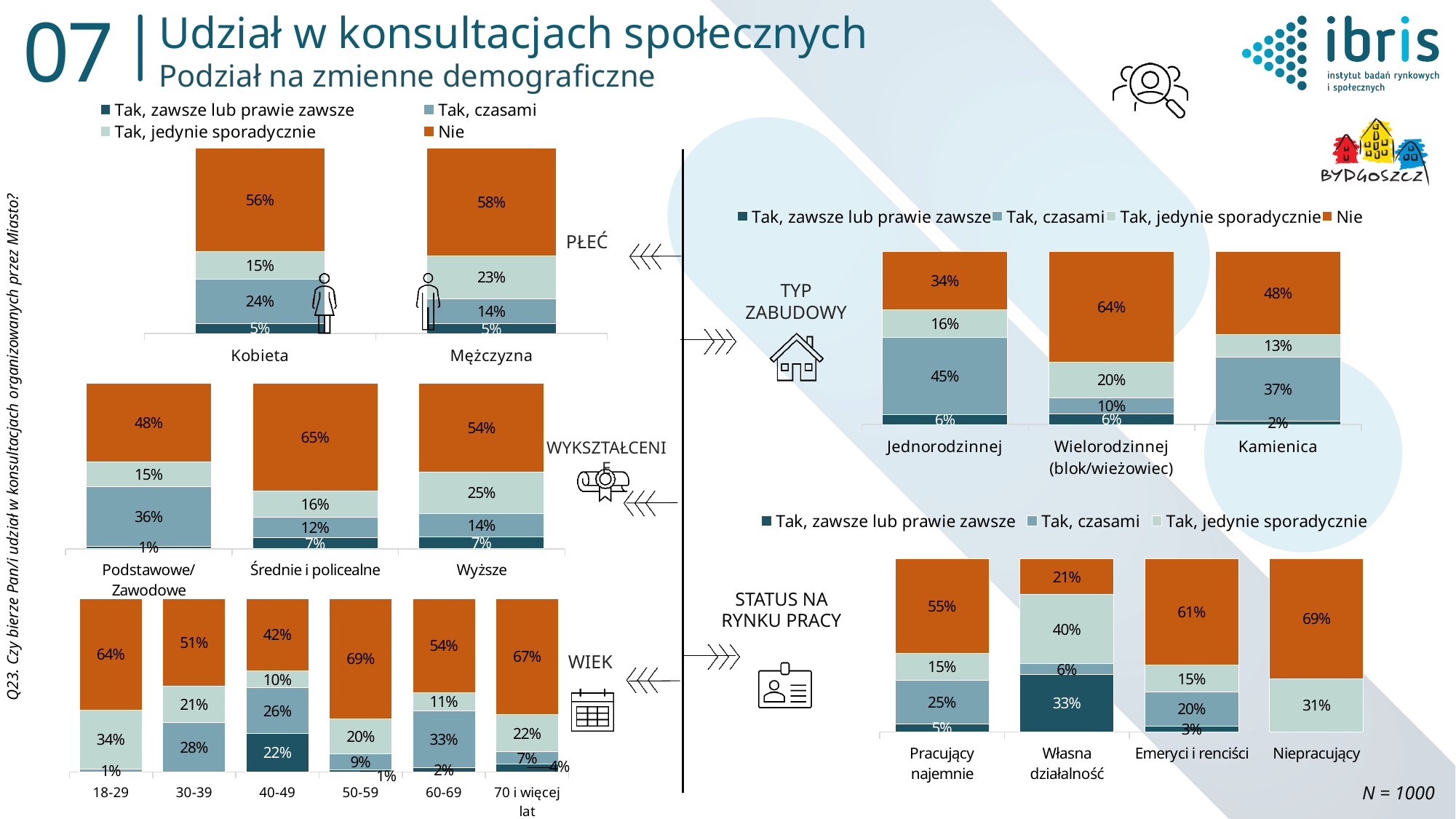
In the WIEK chart, how many age groups are shown? 6 In the TYP ZABUDOWY chart, what is the value of "Tak, czasami" for Jednorodzinnej? 45% In the STATUS NA RYNKU PRACY chart, what is the value of "Tak, jedynie sporadycznie" for Niepracujący? 31% In the WYKSZTAŁCENIE chart, what is the difference between the "Nie" values for Średnie i policealne and Wyższe? 11 percentage points In the STATUS NA RYNKU PRACY chart, is the "Nie" value larger for Emeryci i renciści or for Własna działalność? Emeryci i renciści In the WIEK chart, which age group has the lowest "Nie" value? 40-49 In the WIEK chart, what is the value of "Tak, zawsze lub prawie zawsze" for the 40-49 group? 22% What type of chart is used in the PŁEĆ section? Stacked bar chart In the WYKSZTAŁCENIE chart, which education category has the highest "Nie" value? Średnie i policealne In the PŁEĆ chart, what is the value of "Tak, czasami" for Mężczyzna? 14% In the TYP ZABUDOWY chart, which building type has the highest "Nie" value? Wielorodzinnej (blok/wieżowiec) In the PŁEĆ chart, what is the value of "Nie" for Kobieta? 56%